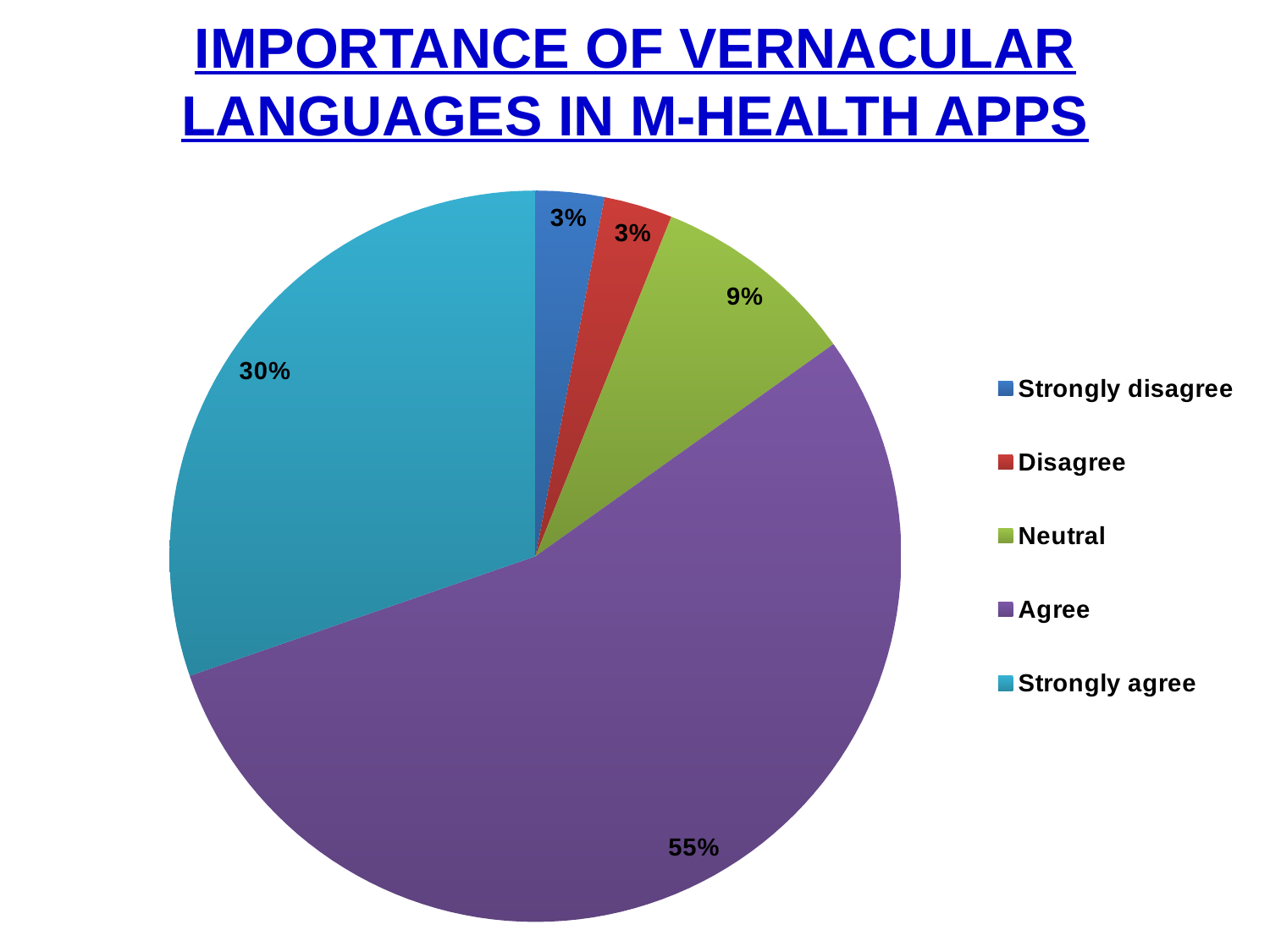
What share of the pie does Strongly agree have? 30% What is the value for Strongly disagree? 3% Which category is shown in green in the legend? Neutral Which is larger, the Neutral slice or the Disagree slice? Neutral What share of the pie does Agree have? 55% What is the title of the chart on the slide? IMPORTANCE OF VERNACULAR LANGUAGES IN M-HEALTH APPS How many categories does the legend list? 5 What is the value for Neutral? 9% What is the combined share of Agree and Strongly agree? 85% What kind of chart is shown on the slide? pie chart Which category has the largest slice of the pie? Agree What is the difference between the Agree and Strongly agree shares? 25%